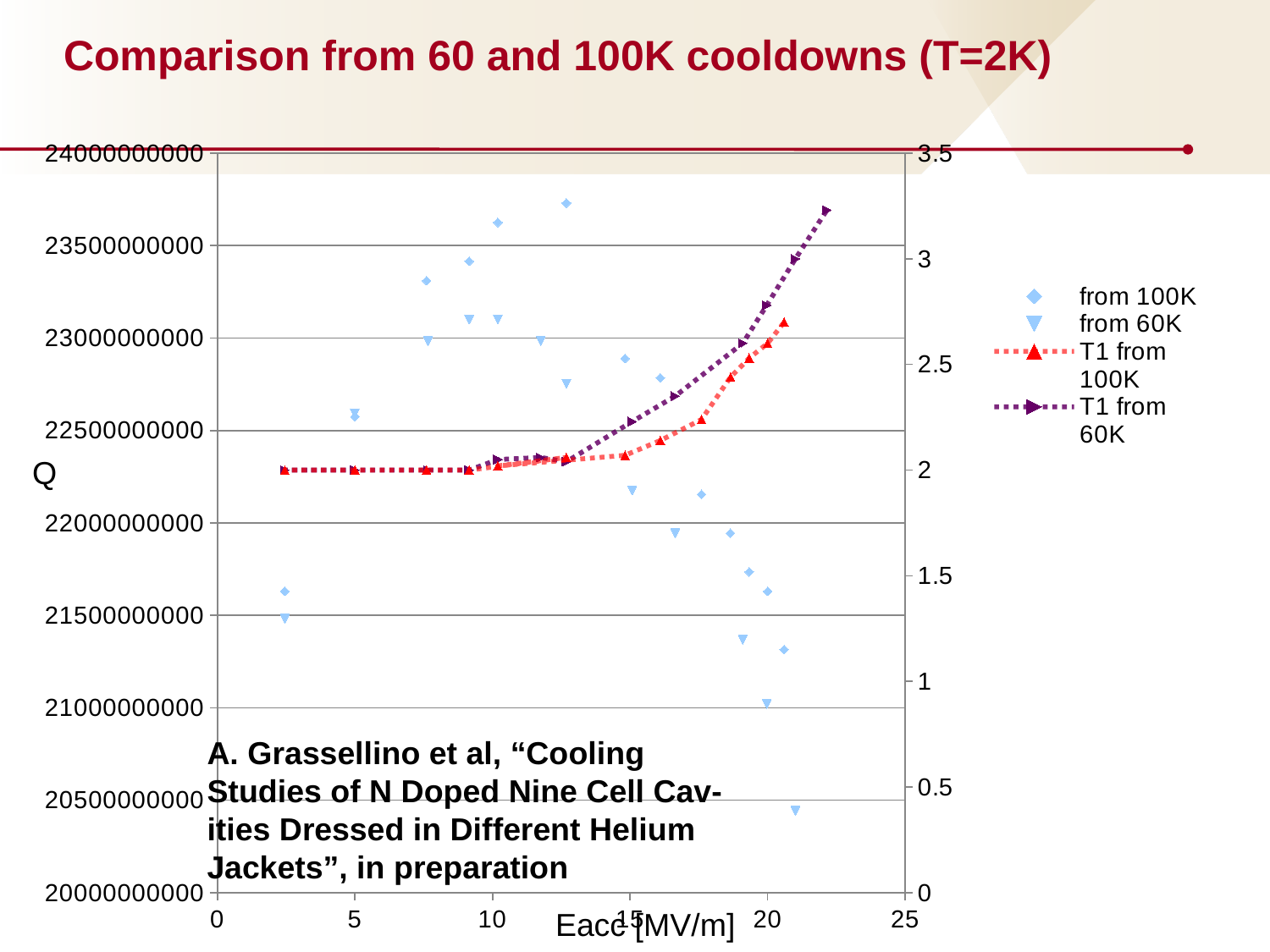
Which series reaches the highest value on the right-hand axis? T1 from 60K Does the 'T1 from 100K' series rise or fall as Eacc increases? rise At Eacc of about 20 MV/m, which is larger: 'T1 from 60K' or 'T1 from 100K'? T1 from 60K Is the highest 'T1 from 60K' value (right axis) greater or less than 3? greater Is the highest 'T1 from 100K' value (right axis) greater or less than 2.5? greater Does the 'T1 from 60K' series rise or fall as Eacc increases? rise Is the 'from 60K' value at Eacc of about 20 MV/m greater or less than 21500000000? less What is the title of the slide's chart? Comparison from 60 and 100K cooldowns (T=2K) What kind of chart is shown on the slide? scatter chart How many series does the legend list? 4 What is the label of the x axis? Eacc [MV/m]